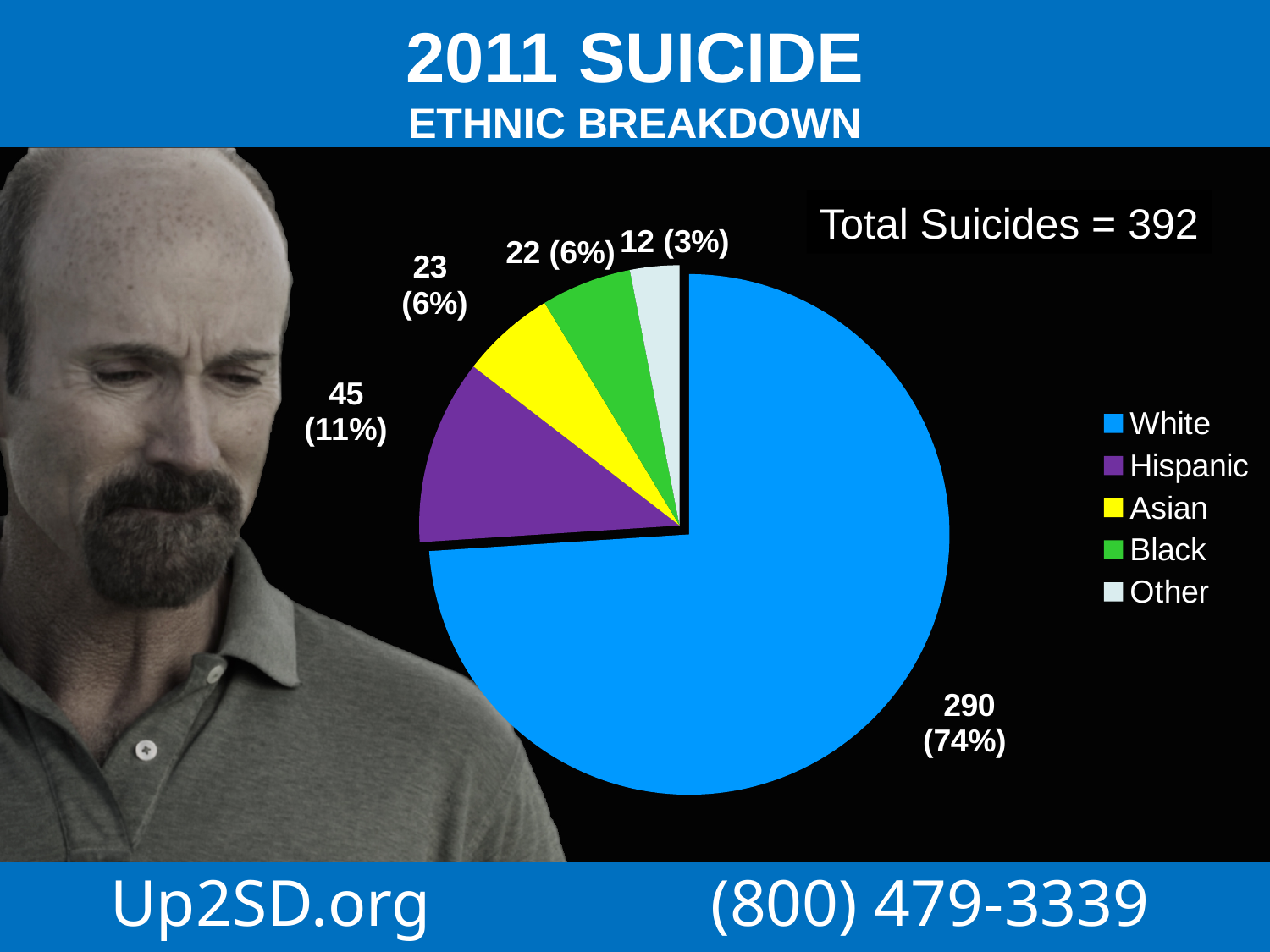
What is the difference between the White and Hispanic counts? 245 What percentage of the pie does the Hispanic slice represent? 11% Which category has the largest slice of the pie? White What percentage share does the Other slice have? 3% How many categories does the pie chart have? 5 How many suicides are attributed to the Asian category? 23 What colour is the Asian slice in the pie chart? yellow How many suicides are attributed to the White category? 290 What kind of chart is shown on the slide? pie chart Which category has the smallest slice of the pie? Other What is the total number of suicides stated on the slide? 392 Which is larger, the Hispanic count or the Black count? Hispanic